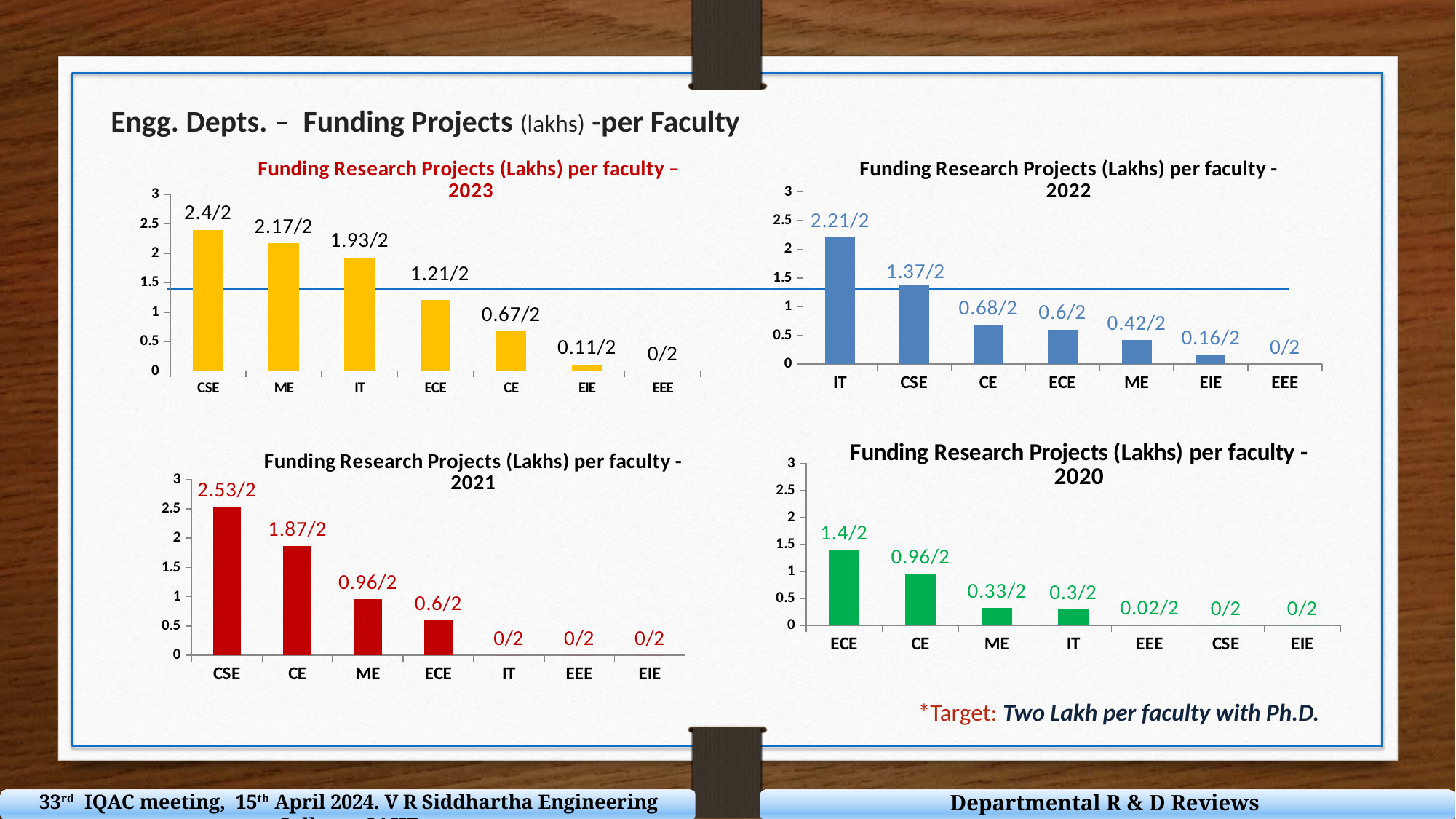
In the 2022 chart (top right), which department has the lowest value? EEE In the 2023 chart (top left), which department has the highest value? CSE In the 2020 chart (bottom right), do the values rise or fall from left to right along the x axis? fall In the 2022 chart (top right), what is the data label shown for IT? 2.21/2 In the 2023 chart (top left), is the value for ME larger or smaller than the value for IT? larger In the 2021 chart (bottom left), how many departments are shown on the x axis? 7 In the 2022 chart (top right), is the value for CSE greater or less than 1? greater In the 2021 chart (bottom left), what is the data label shown for CE? 1.87/2 What kind of chart is the 2021 chart (bottom left)? bar chart In the 2020 chart (bottom right), what is the data label shown for ECE? 1.4/2 In the 2023 chart (top left), what is the data label shown for CSE? 2.4/2 In the 2020 chart (bottom right), which department has the highest value? ECE